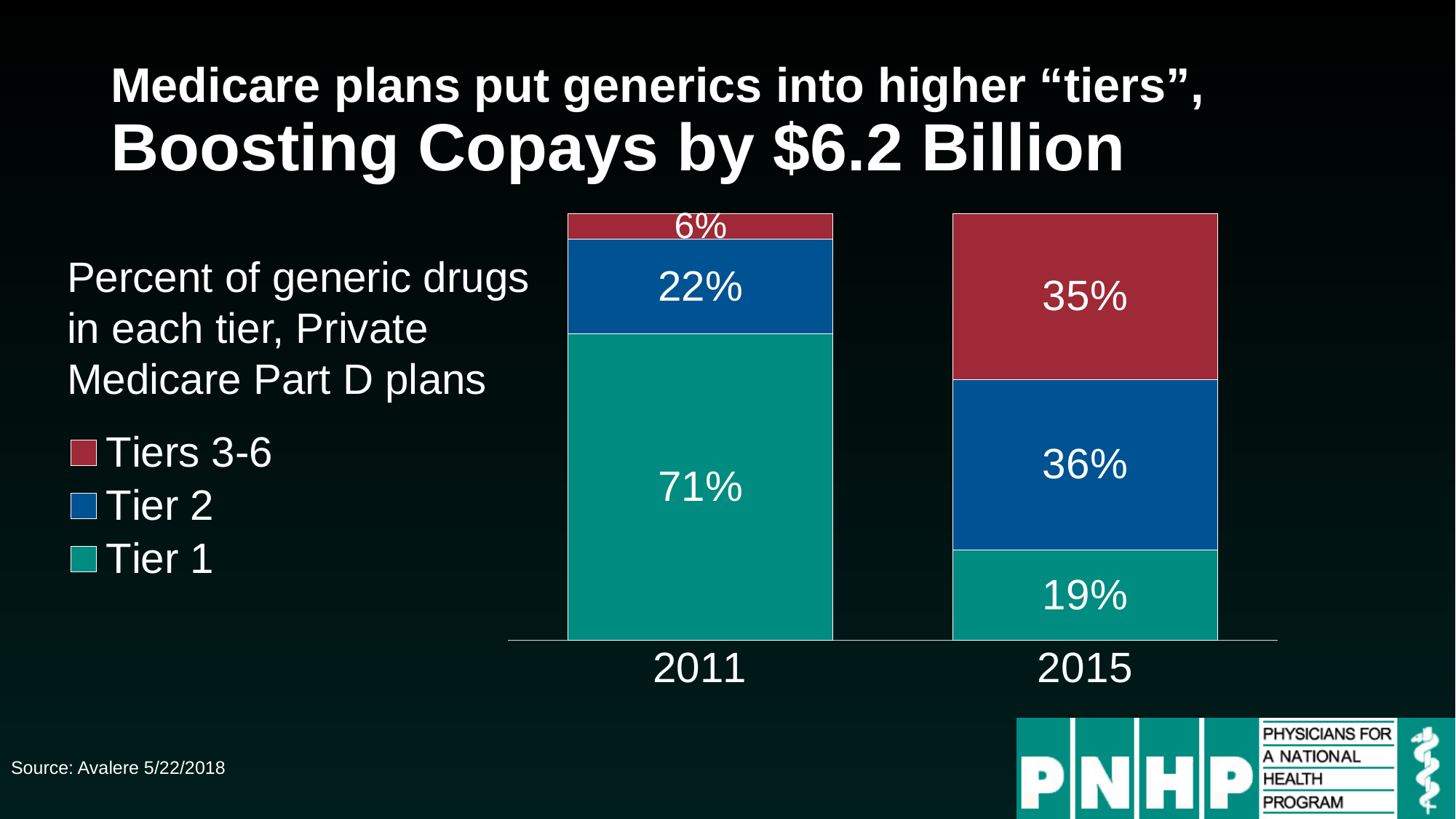
What percent of generic drugs were in Tiers 3-6 in 2015? 35% Which is larger: the Tier 2 share in 2011 or the Tier 2 share in 2015? 2015 Which tier had the largest share of generic drugs in 2011? Tier 1 What kind of chart is shown on the slide? Stacked bar chart What percent of generic drugs were in Tier 2 in 2015? 36% How many years are shown on the x axis? 2 By how many percentage points did the Tier 1 share fall from 2011 to 2015? 52 percentage points What percent of generic drugs were in Tiers 3-6 in 2011? 6% Which colour represents Tiers 3-6 in the chart? Red How many series does the legend list? 3 Which tier had the smallest share of generic drugs in 2015? Tier 1 What percent of generic drugs were in Tier 1 in 2011? 71%